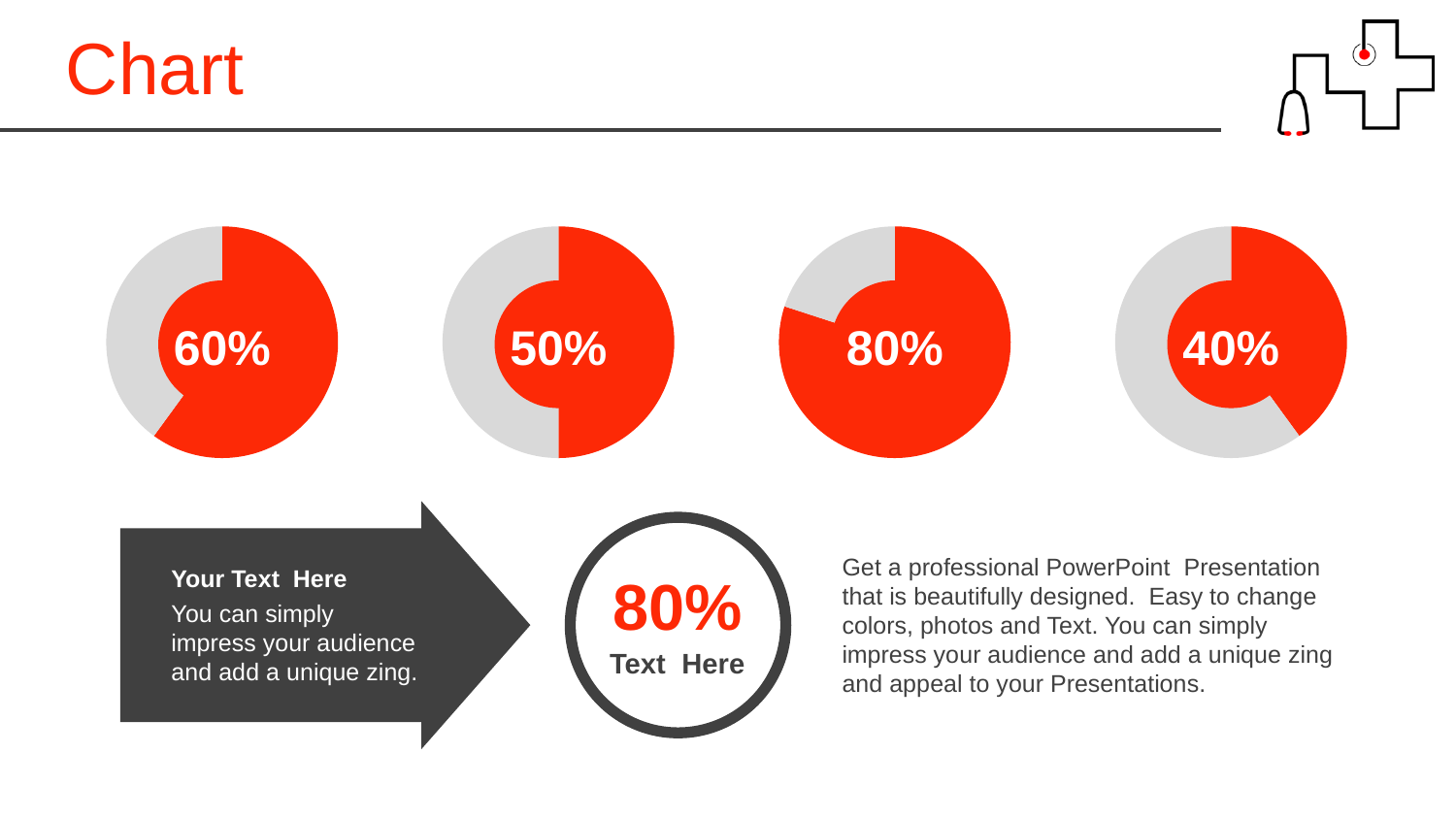
How many pie charts are in the top row of the slide? 4 In the second pie chart from the left, what percentage is shown? 50% What colour is the filled portion of each pie chart in the top row? Red In the first pie chart from the left, what share of the pie is the grey (unfilled) portion? 40% In the fourth pie chart from the left, what percentage is shown? 40% Which shows a larger percentage, the first pie chart or the second pie chart from the left? The first (60%) What kind of chart is used in the top row of the slide? Pie chart In the first pie chart from the left, what percentage is shown? 60% What is the difference between the percentage in the third pie chart and the percentage in the fourth pie chart? 40 percentage points Which of the four pie charts in the top row shows the highest percentage? The third from the left (80%) Which of the four pie charts in the top row shows the lowest percentage? The fourth from the left (40%) In the third pie chart from the left, what percentage is shown? 80%